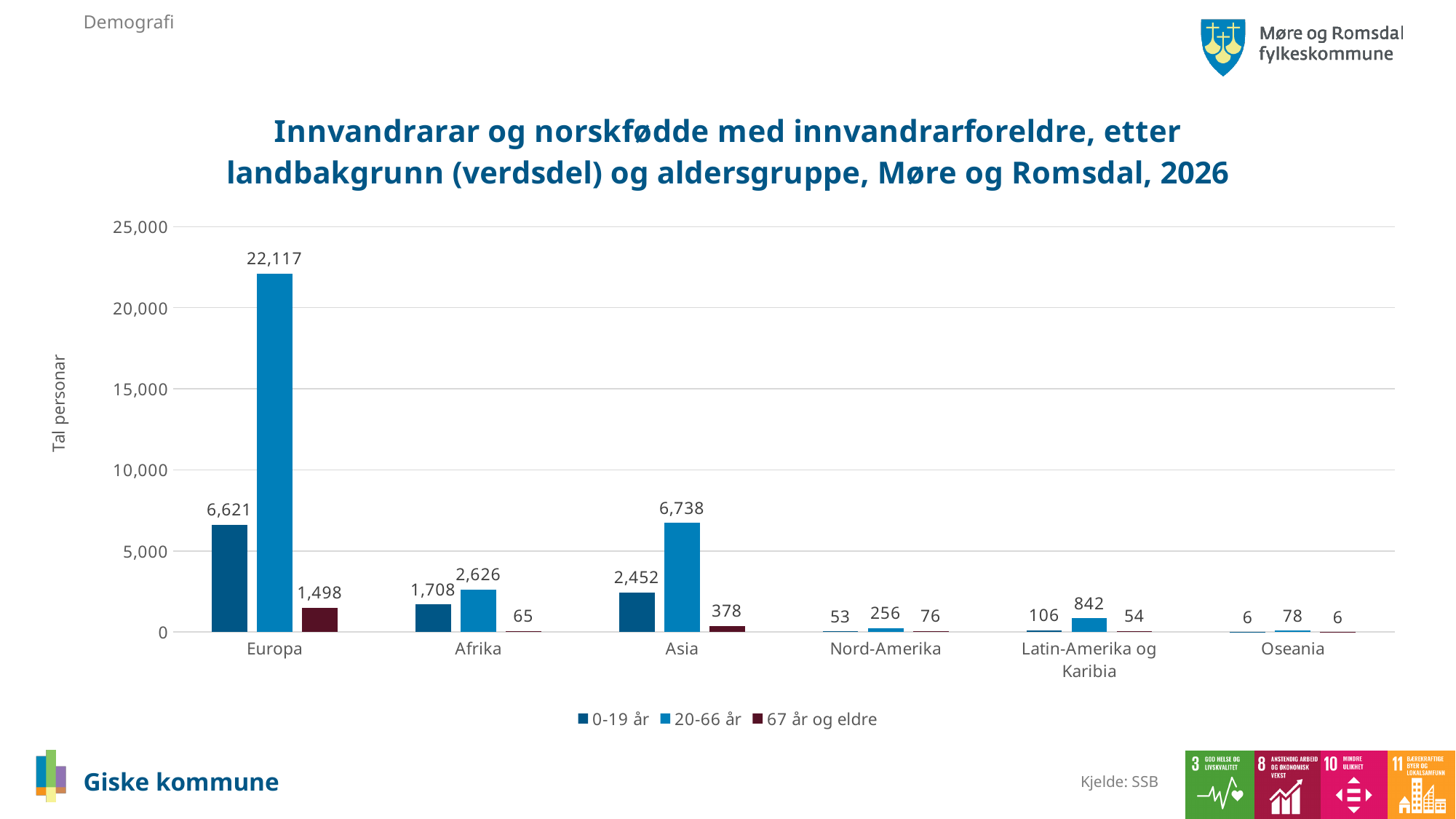
What is the value for the 20-66 år series for Europa? 22,117 Which is larger: the 0-19 år value for Afrika or the 0-19 år value for Asia? Asia How many series does the legend list? 3 Which region has the lowest value for the 0-19 år series? Oseania What is the value for the 20-66 år series for Latin-Amerika og Karibia? 842 Which region has the highest value for the 20-66 år series? Europa What is the difference between the 20-66 år and 0-19 år values for Europa? 15,496 What is the value for the 0-19 år series for Asia? 2,452 What kind of chart is shown on the slide? bar chart What is the value for the 67 år og eldre series for Afrika? 65 How many regions are shown on the x axis? 6 Is the value for the 20-66 år series for Asia greater or less than 5,000? greater